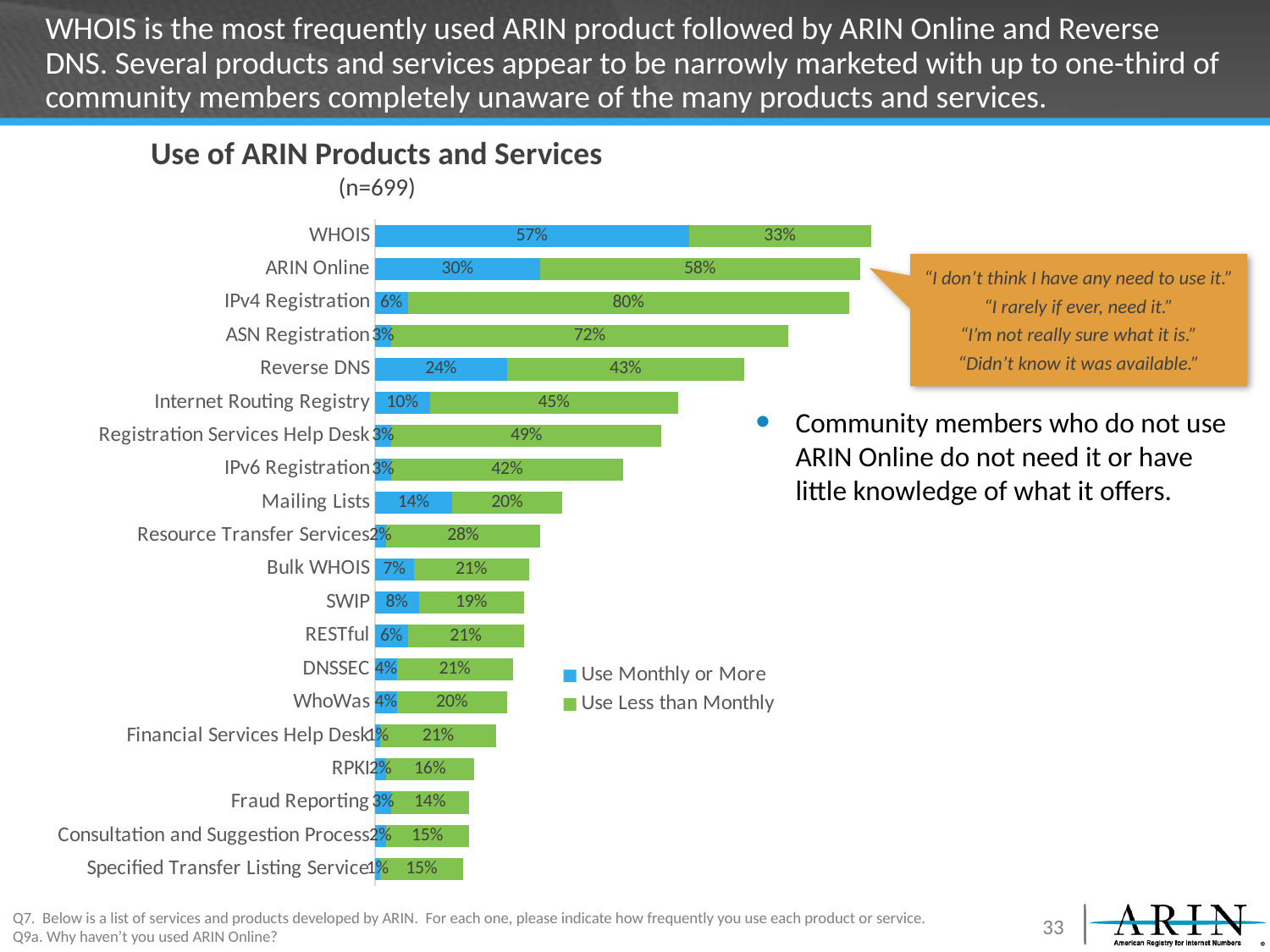
What is the 'Use Monthly or More' value for Reverse DNS? 24% Which product has the highest 'Use Less than Monthly' value? IPv4 Registration What is the 'Use Less than Monthly' value for IPv4 Registration? 80% What kind of chart is shown on the slide? Stacked bar chart What is the sample size shown under the chart title? n=699 Which product has the highest 'Use Monthly or More' value? WHOIS How many series does the legend list? 2 What is the total of the stacked bar for ARIN Online? 88% Which is larger: the 'Use Monthly or More' value for Mailing Lists or for Internet Routing Registry? Mailing Lists How many products and services are listed in the chart? 20 What percentage of respondents use WHOIS monthly or more? 57% What is the difference between the 'Use Monthly or More' values for WHOIS and ARIN Online? 27%